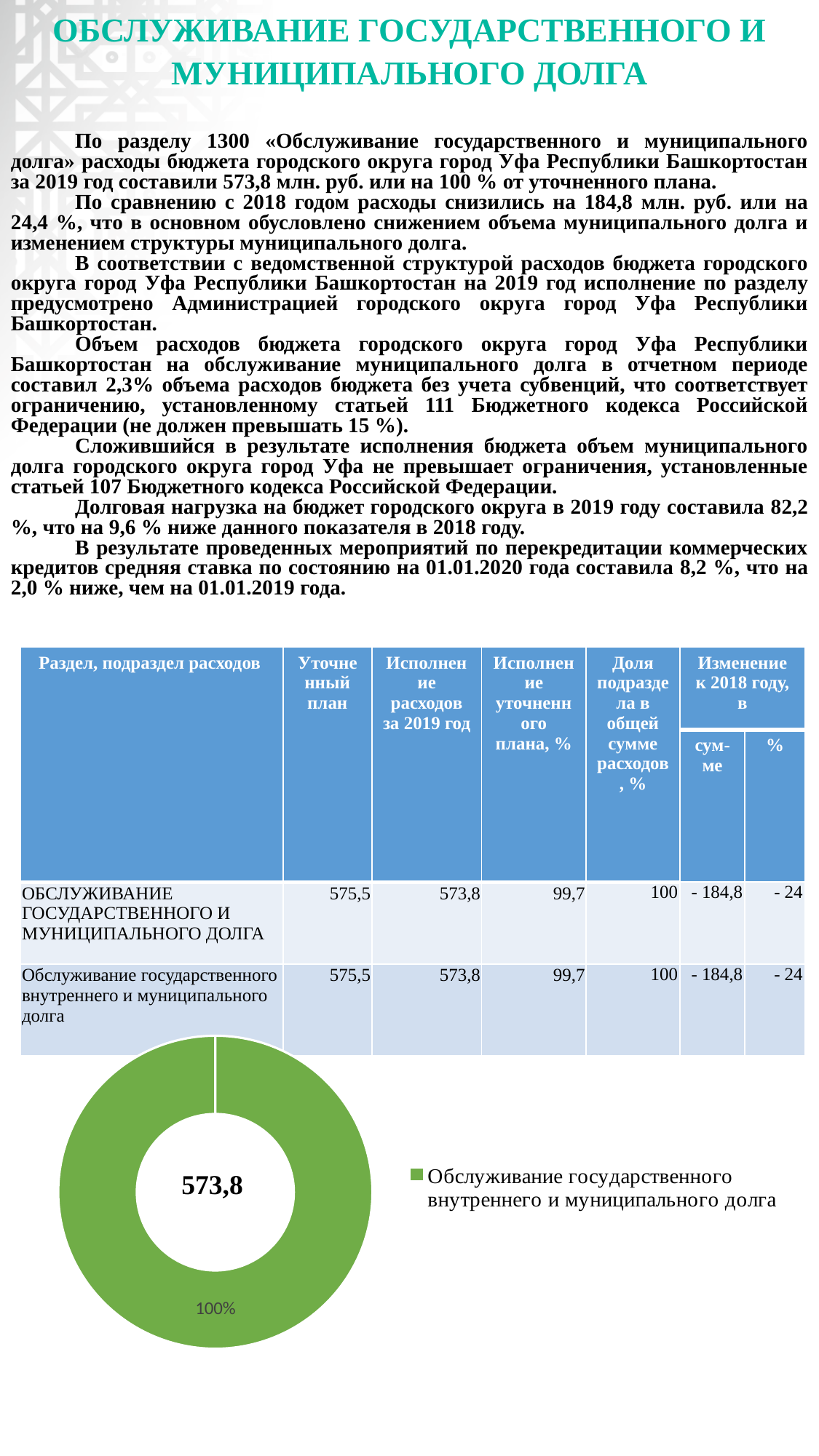
How many entries does the legend of the doughnut chart list? 1 What data label is printed on the slice of the doughnut chart? 100% What colour is the slice in the doughnut chart? green What is the legend entry of the doughnut chart? Обслуживание государственного внутреннего и муниципального долга How many slices does the doughnut chart have? 1 What share of the doughnut chart does the slice "Обслуживание государственного внутреннего и муниципального долга" take? 100% What value is printed in the centre of the doughnut chart? 573,8 What kind of chart is shown at the bottom of the slide? doughnut chart